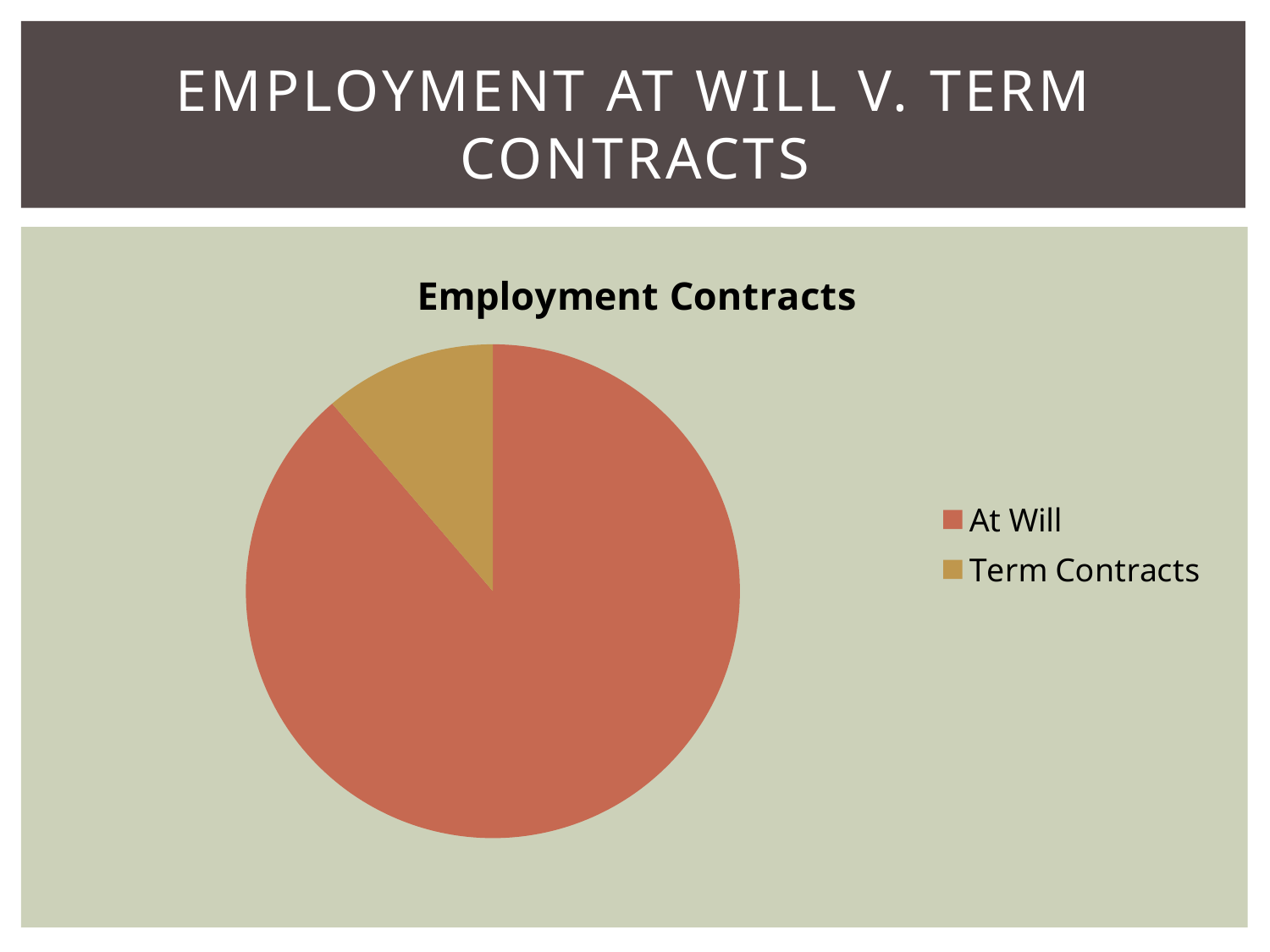
What is the title of the chart? Employment Contracts Is the share of the pie for Term Contracts greater or less than 50%? less Which legend entry is shown in red? At Will Is the share of the pie for At Will greater or less than 50%? greater How many slices does the pie chart have? 2 What kind of chart is shown on the slide? pie chart Which slice of the pie is the smallest? Term Contracts Which slice of the pie is the largest? At Will How many entries does the legend list? 2 Which is larger, the At Will slice or the Term Contracts slice? At Will